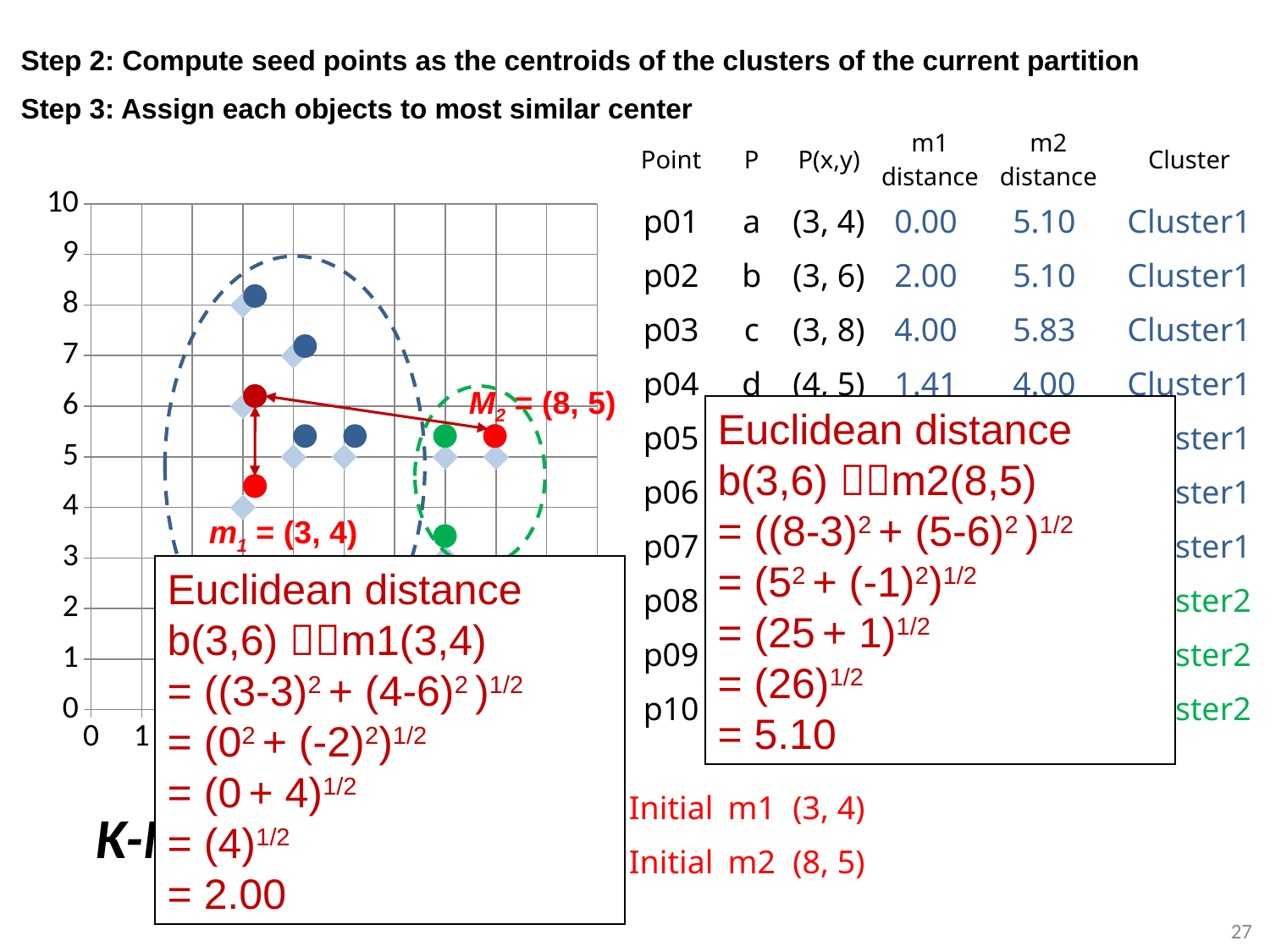
Which seed point has the larger x coordinate, m1 or M2? M2 What are the coordinates of the seed point labelled M2 on the chart? (8, 5) What is the highest value shown on the chart's y axis? 10 How many blue points are plotted on the chart? 4 How many dashed cluster outlines are drawn on the chart? 2 According to the table, which cluster is point d (4, 5) assigned to? Cluster1 According to the table, what is the m2 distance for point c (3, 8)? 5.83 What kind of chart is shown on the left of the slide? scatter chart According to the table, what is the m1 distance for point b (3, 6)? 2.00 What are the coordinates of the seed point labelled m1 on the chart? (3, 4) Is the y value of the seed point m1 greater or less than 5? less Is the x value of the seed point M2 greater or less than 5? greater